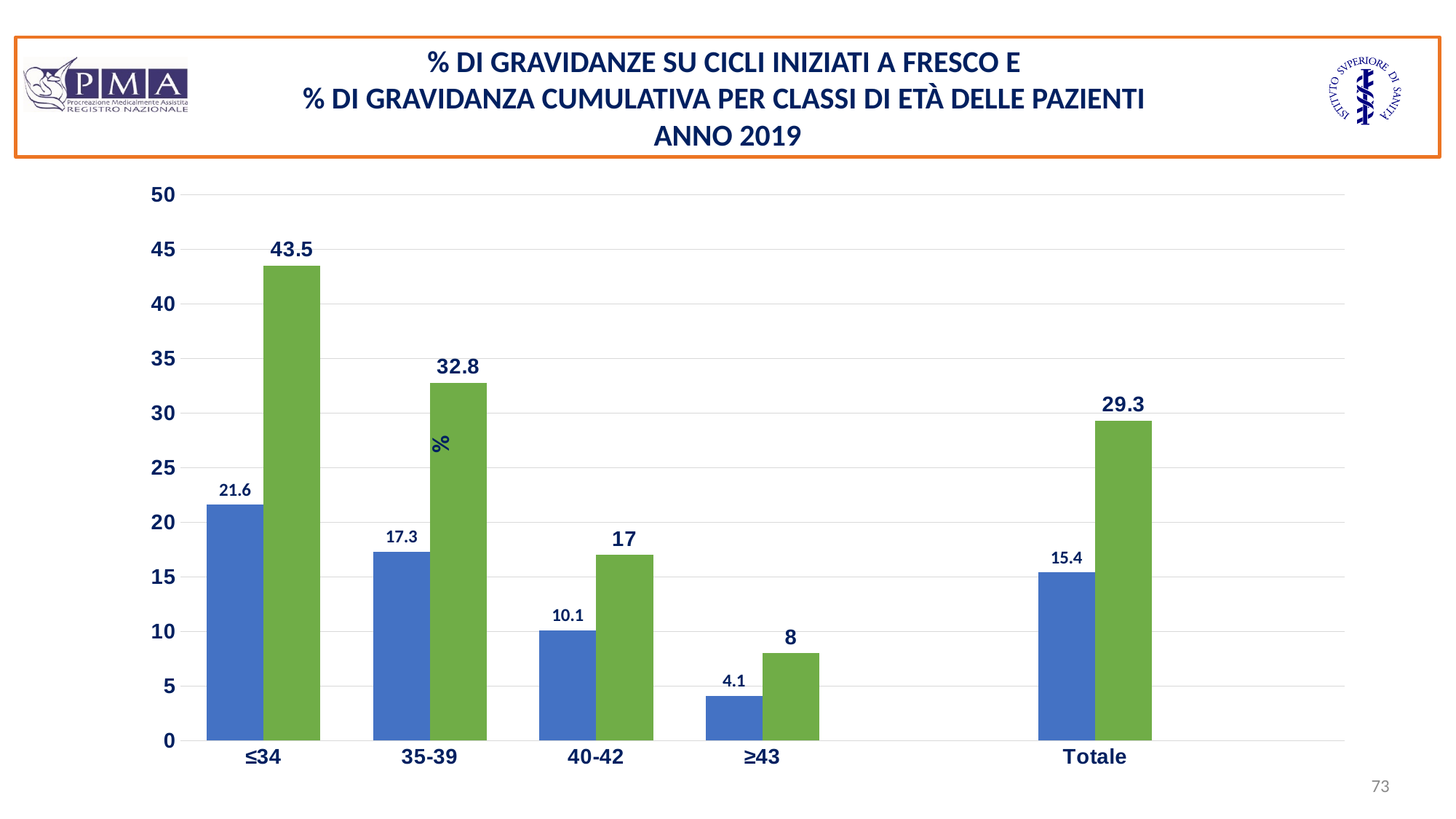
Which category has the lowest blue bar? ≥43 Which age class has the highest green bar? ≤34 What is the value of the blue bar for the ≤34 age class? 21.6 How many categories are shown on the x axis? 5 What is the value of the green bar for the 35-39 age class? 32.8 What year does the chart title refer to? 2019 What is the value of the blue bar for the ≥43 age class? 4.1 What kind of chart is shown on the slide? bar chart What is the value of the green bar for the Totale category? 29.3 What is the difference between the green and blue bars for the 40-42 age class? 6.9 Do the blue bar values rise or fall from the ≤34 age class to the ≥43 age class? fall Which is larger for the 35-39 age class, the blue bar or the green bar? the green bar